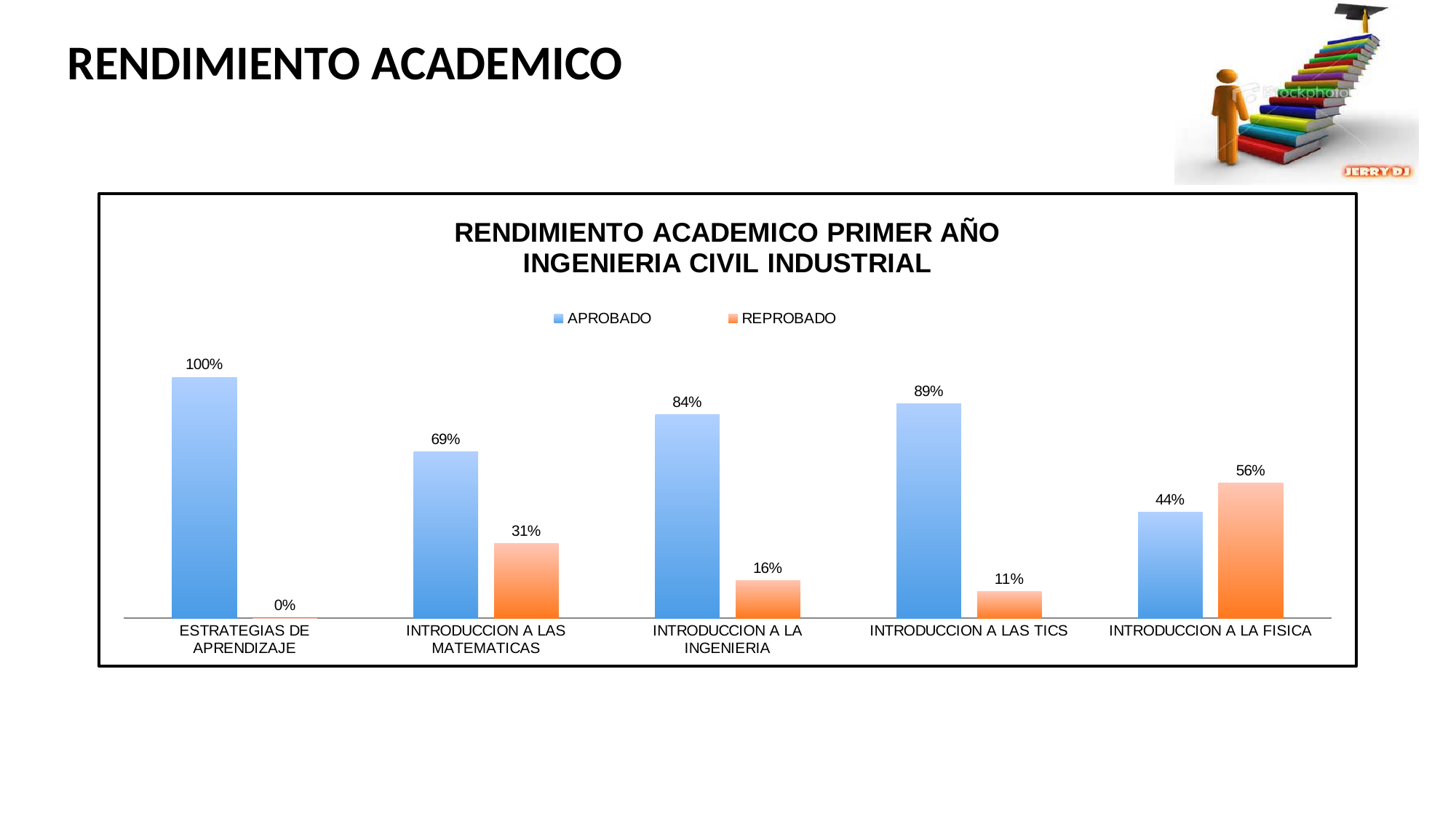
What is the REPROBADO value for ESTRATEGIAS DE APRENDIZAJE? 0% What is the title of the chart? RENDIMIENTO ACADEMICO PRIMER AÑO INGENIERIA CIVIL INDUSTRIAL Which category has the highest APROBADO value? ESTRATEGIAS DE APRENDIZAJE How many series does the legend list? 2 Which is larger for INTRODUCCION A LA FISICA, APROBADO or REPROBADO? REPROBADO What is the REPROBADO value for INTRODUCCION A LA FISICA? 56% How many categories are shown on the x axis? 5 What is the difference between the APROBADO and REPROBADO values for INTRODUCCION A LA INGENIERIA? 68% What is the APROBADO value for INTRODUCCION A LAS MATEMATICAS? 69% What kind of chart is shown on the slide? Bar chart Which category has the highest REPROBADO value? INTRODUCCION A LA FISICA Which category has the lowest APROBADO value? INTRODUCCION A LA FISICA